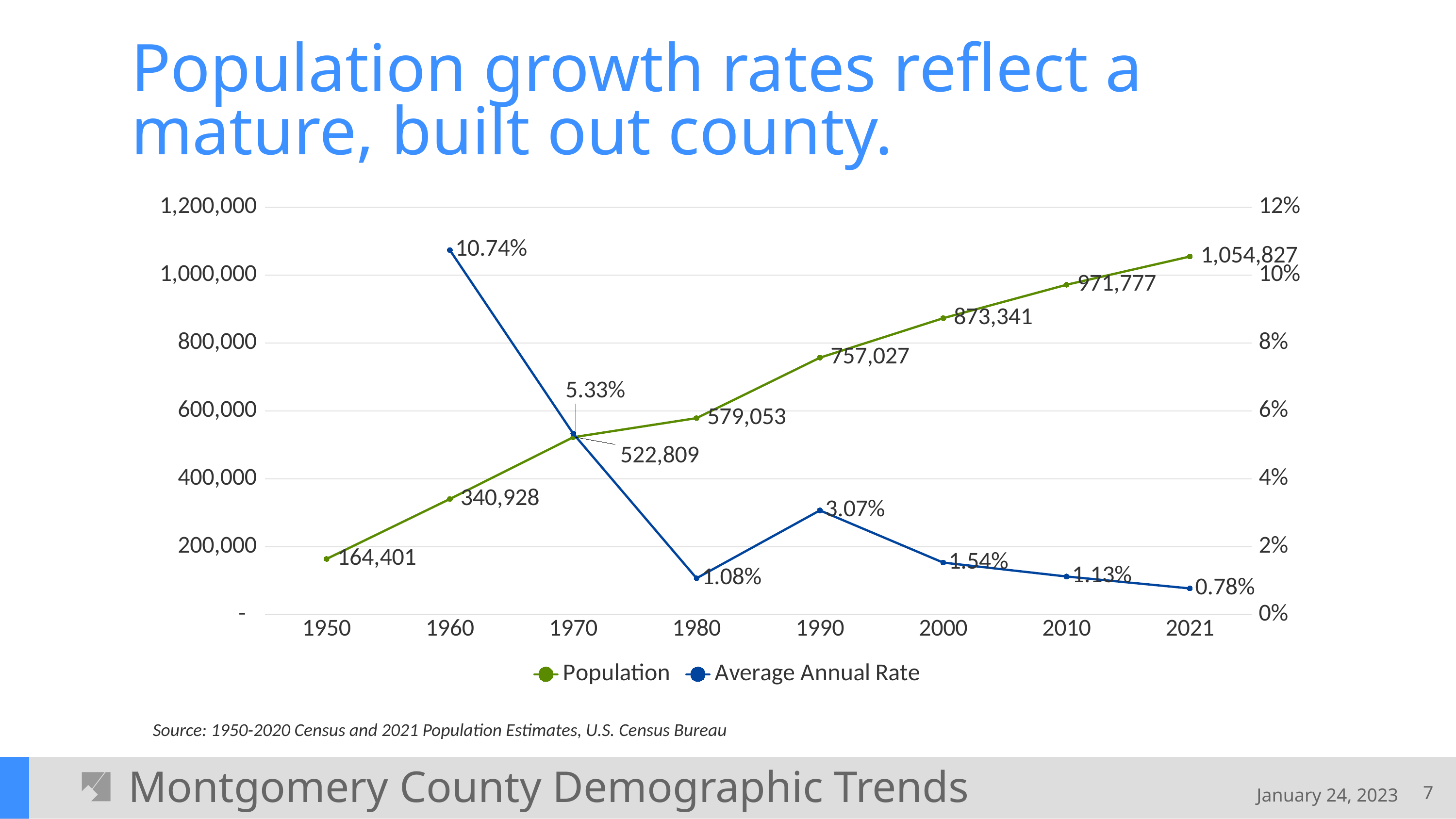
What kind of chart is shown on the slide? line chart What is the Average Annual Rate for 1960? 10.74% How many years are shown on the x axis? 8 What is the Average Annual Rate for 1990? 3.07% In which year is the Average Annual Rate lowest? 2021 What is the Population value for 1950? 164,401 Which is larger, the Average Annual Rate for 1980 or for 2000? 2000 How many series does the legend list? 2 What is the Population value for 2021? 1,054,827 Is the Population value for 1990 greater or less than 800,000? less What is the difference in Population between 2010 and 2000? 98,436 In which year is the Average Annual Rate highest? 1960